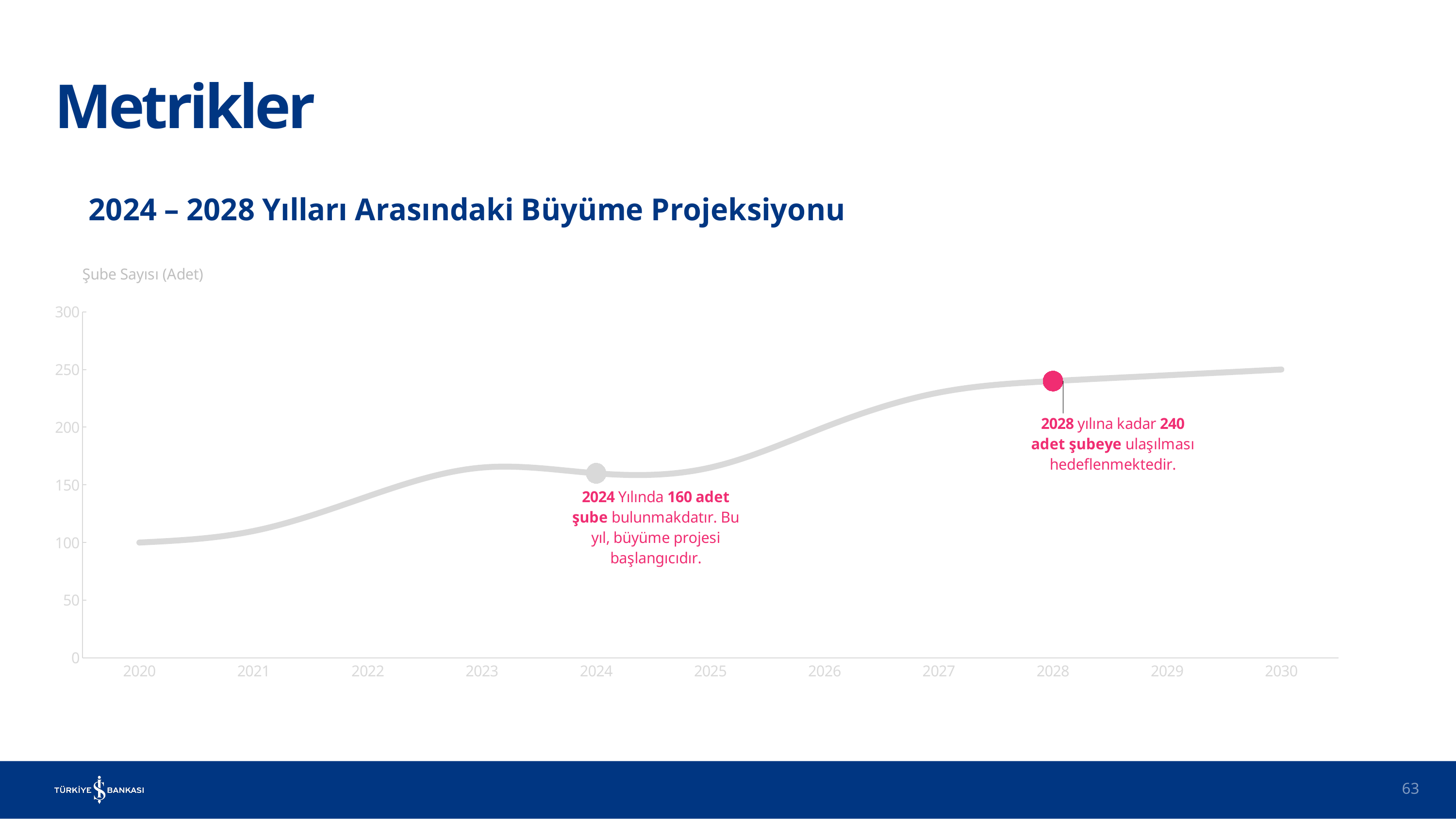
What is the label of the y axis of the chart? Şube Sayısı (Adet) What kind of chart is shown on the slide? line chart What is the targeted number of branches for 2028 according to the annotation? 240 Which year has the higher branch count, 2024 or 2028? 2028 Is the value for 2020 greater or less than 150? less Does the line generally rise or fall from 2020 to 2030? rise By how many branches is the 2028 target higher than the 2024 value? 80 How many years are labelled on the x axis of the chart? 11 Is the value for 2022 greater or less than 150? less Is the value for 2030 greater or less than 200? greater What is the number of branches (Şube Sayısı) shown for 2024? 160